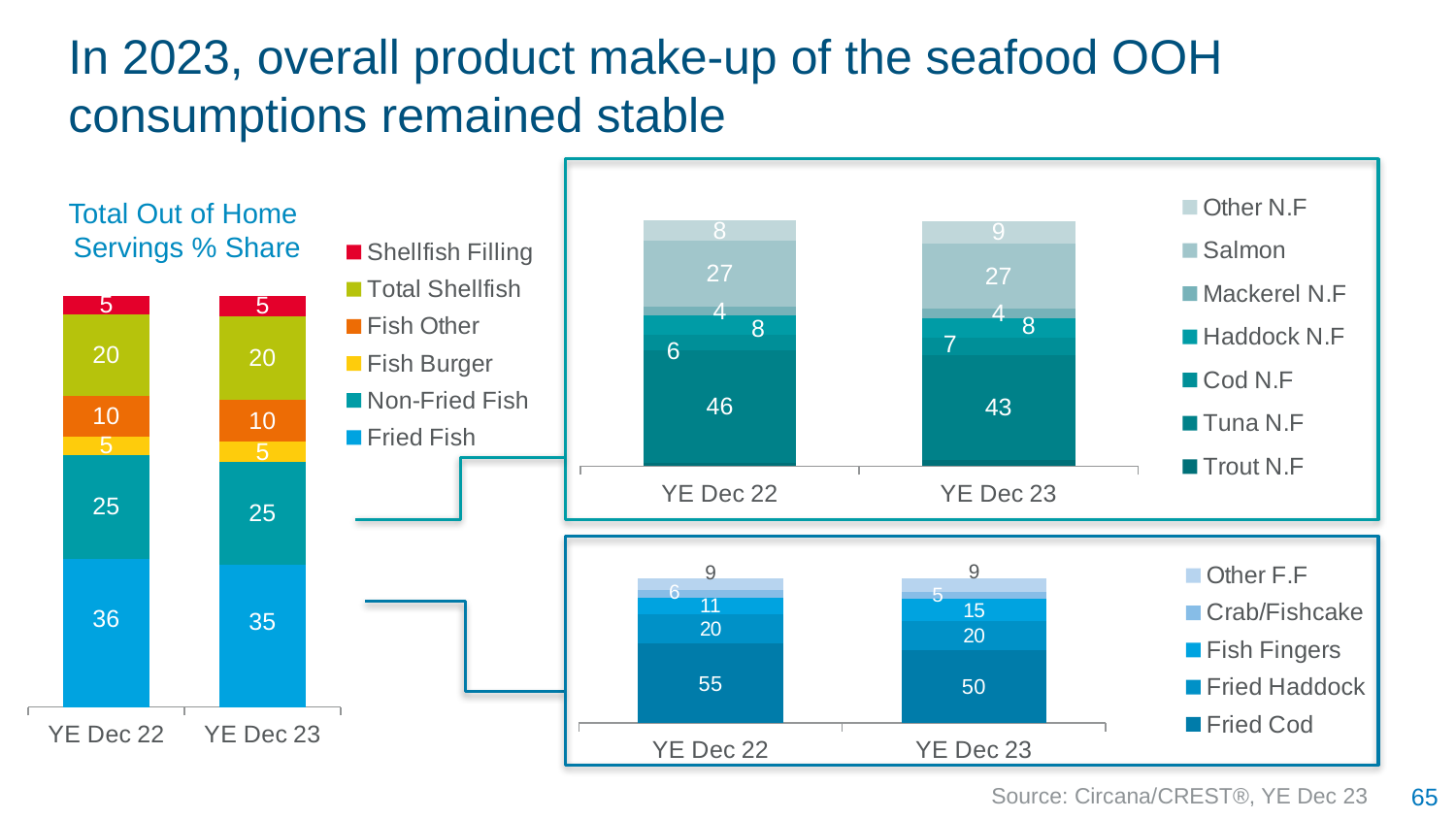
In the 'Total Out of Home Servings % Share' chart, which segment is the largest in the YE Dec 22 bar? Fried Fish In the 'Total Out of Home Servings % Share' chart, what is the difference between Fried Fish in YE Dec 22 and YE Dec 23? 1 In the bottom-right chart (fried fish breakdown), what is the value for Fried Cod in YE Dec 22? 55 In the 'Total Out of Home Servings % Share' chart, what is the value for Non-Fried Fish in YE Dec 22? 25 In the 'Total Out of Home Servings % Share' chart, what is the value for Fried Fish in YE Dec 23? 35 In the 'Total Out of Home Servings % Share' chart, what is the value for Fried Fish in YE Dec 22? 36 What kind of chart is the 'Total Out of Home Servings % Share' chart? Stacked bar chart How many series does the legend of the top-right chart (non-fried fish breakdown) list? 7 In the top-right chart (non-fried fish breakdown), what is the value of the largest segment in the YE Dec 23 bar? 43 In the 'Total Out of Home Servings % Share' chart, what is the value for Total Shellfish in YE Dec 23? 20 In the bottom-right chart (fried fish breakdown), is the Fried Cod value larger in YE Dec 22 or YE Dec 23? YE Dec 22 How many series does the legend of the 'Total Out of Home Servings % Share' chart list? 6